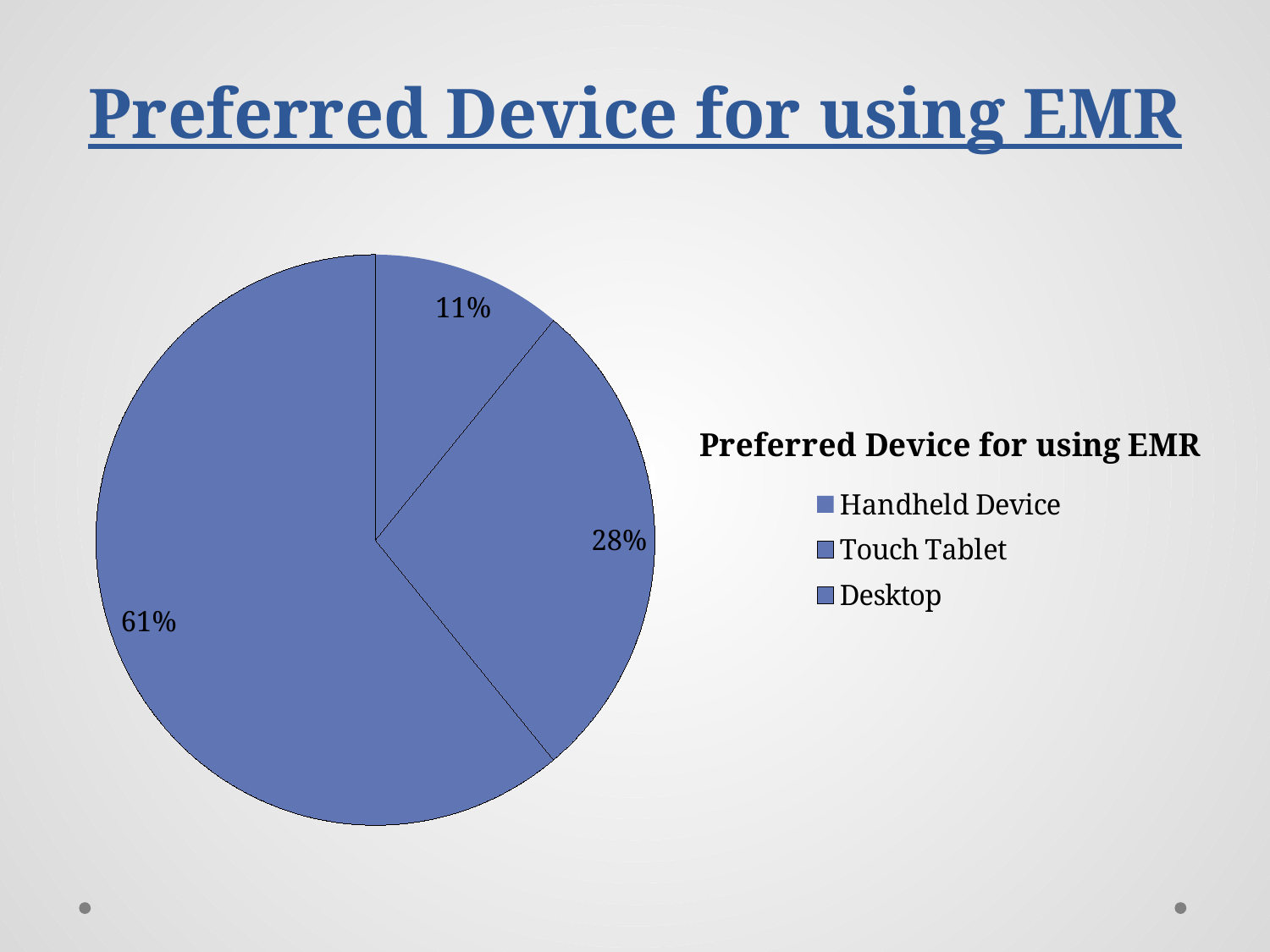
What is the percentage shown on the smallest slice of the pie? 11% What is the difference between the largest slice (61%) and the smallest slice (11%)? 50 percentage points What is the percentage shown on the largest slice of the pie? 61% What is the title of the chart? Preferred Device for using EMR Which legend entry is listed first? Handheld Device Which is larger, the slice labelled 28% or the slice labelled 61%? 61% What is the difference between the 28% slice and the 11% slice? 17 percentage points How many entries does the chart legend list? 3 What do the three slice percentages add up to? 100% What kind of chart is shown on the slide? pie chart Is the largest slice of the pie greater or less than 50%? greater How many slices does the pie chart have? 3